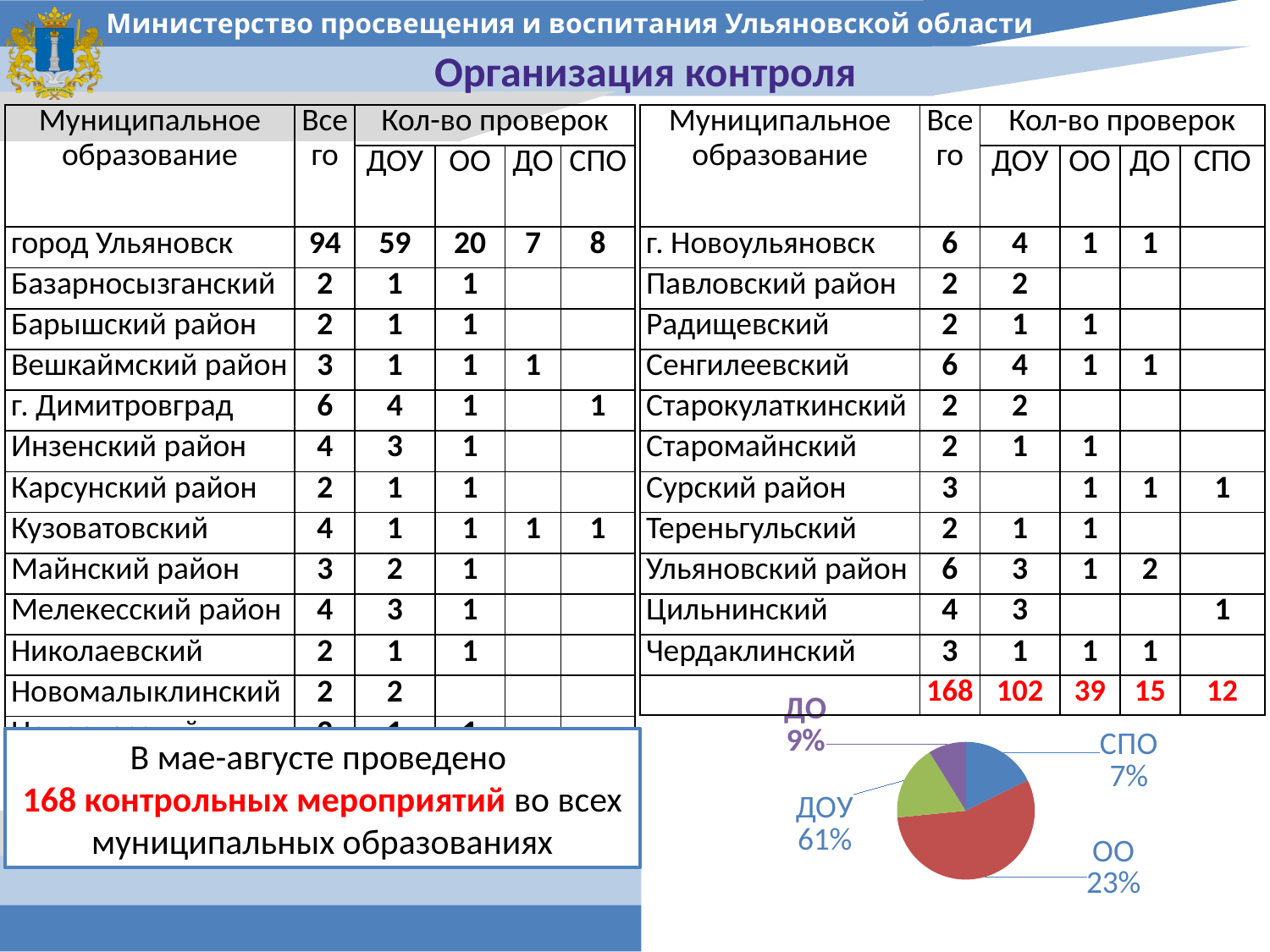
In the pie chart, what share does ДО have? 9% In the pie chart, what share does ДОУ have? 61% In the pie chart, what share does ОО have? 23% In the pie chart, what is the difference in percentage points between ДО and СПО? 2 In the pie chart, what is the difference in percentage points between ДОУ and ОО? 38 How many slices does the pie chart have? 4 What colour is the ДОУ slice in the pie chart? green In the pie chart, what share does СПО have? 7% What kind of chart is shown at the bottom right of the slide? pie chart In the pie chart, which is larger, ОО or ДО? ОО